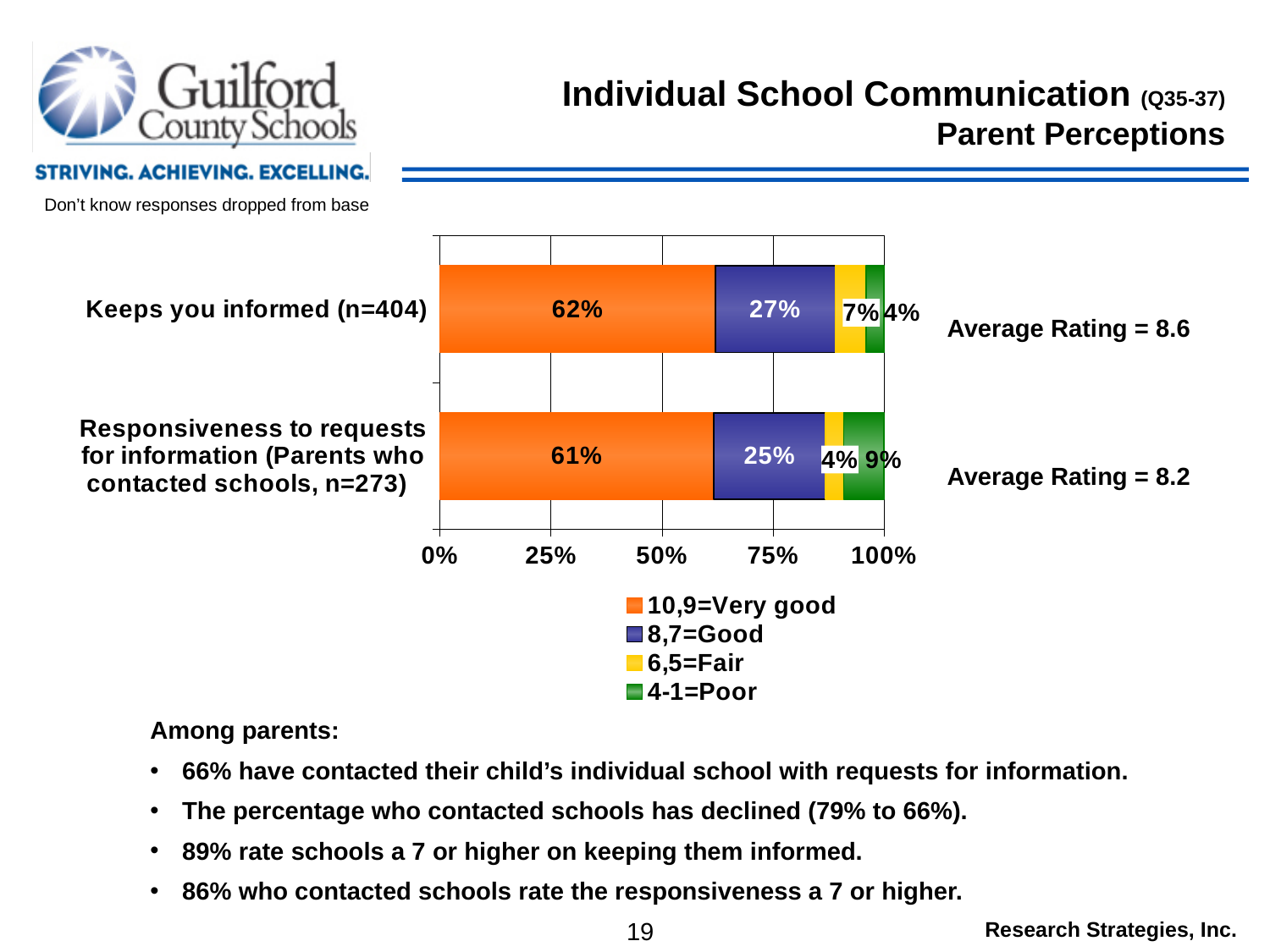
Which colour represents the '4-1=Poor' series in the legend? Green Which category has the higher Very good (10,9) percentage, 'Keeps you informed' or 'Responsiveness to requests for information'? Keeps you informed What kind of chart is shown on the slide? Stacked bar chart What is the difference between the Good (8,7) percentages for 'Keeps you informed' and 'Responsiveness to requests for information'? 2% What is the difference between the Poor (4-1) percentages for 'Responsiveness to requests for information' and 'Keeps you informed'? 5% How many series does the legend list? 4 What percentage of parents rated 'Keeps you informed' as Very good (10,9)? 62% How many categories are plotted on the chart? 2 What percentage of parents rated 'Responsiveness to requests for information' as Fair (6,5)? 4% What percentage of parents rated 'Responsiveness to requests for information' as Good (8,7)? 25% What is the average rating shown for 'Keeps you informed'? 8.6 What percentage of parents rated 'Keeps you informed' as Poor (4-1)? 4%